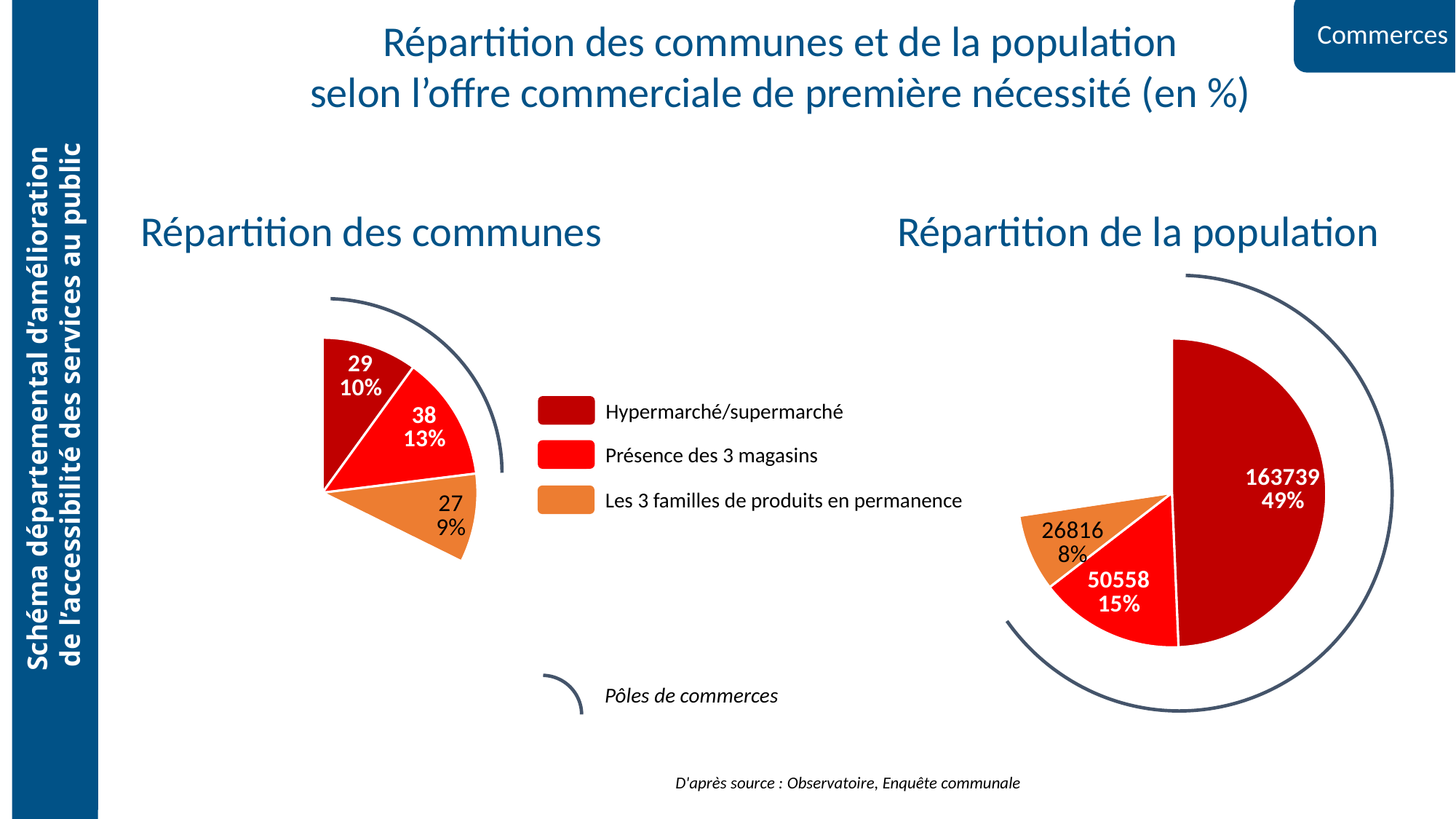
In the 'Répartition des communes' chart, what value is shown for Les 3 familles de produits en permanence? 27 In the 'Répartition de la population' chart, what value is shown for Hypermarché/supermarché? 163739 What kind of chart is used for 'Répartition de la population'? Pie chart In the 'Répartition des communes' chart, what percentage is shown for Présence des 3 magasins? 13% In the 'Répartition de la population' chart, which labelled category has the lowest value? Les 3 familles de produits en permanence In the 'Répartition des communes' chart, what value is shown for Hypermarché/supermarché? 29 In the 'Répartition des communes' chart, which labelled category has the highest value? Présence des 3 magasins In the 'Répartition de la population' chart, what percentage is shown for Présence des 3 magasins? 15% In the 'Répartition des communes' chart, what is the difference between the values for Présence des 3 magasins and Hypermarché/supermarché? 9 In the 'Répartition de la population' chart, which is larger: the value for Présence des 3 magasins or for Les 3 familles de produits en permanence? Présence des 3 magasins How many entries does the legend list? 3 In the 'Répartition de la population' chart, what value is shown for Les 3 familles de produits en permanence? 26816